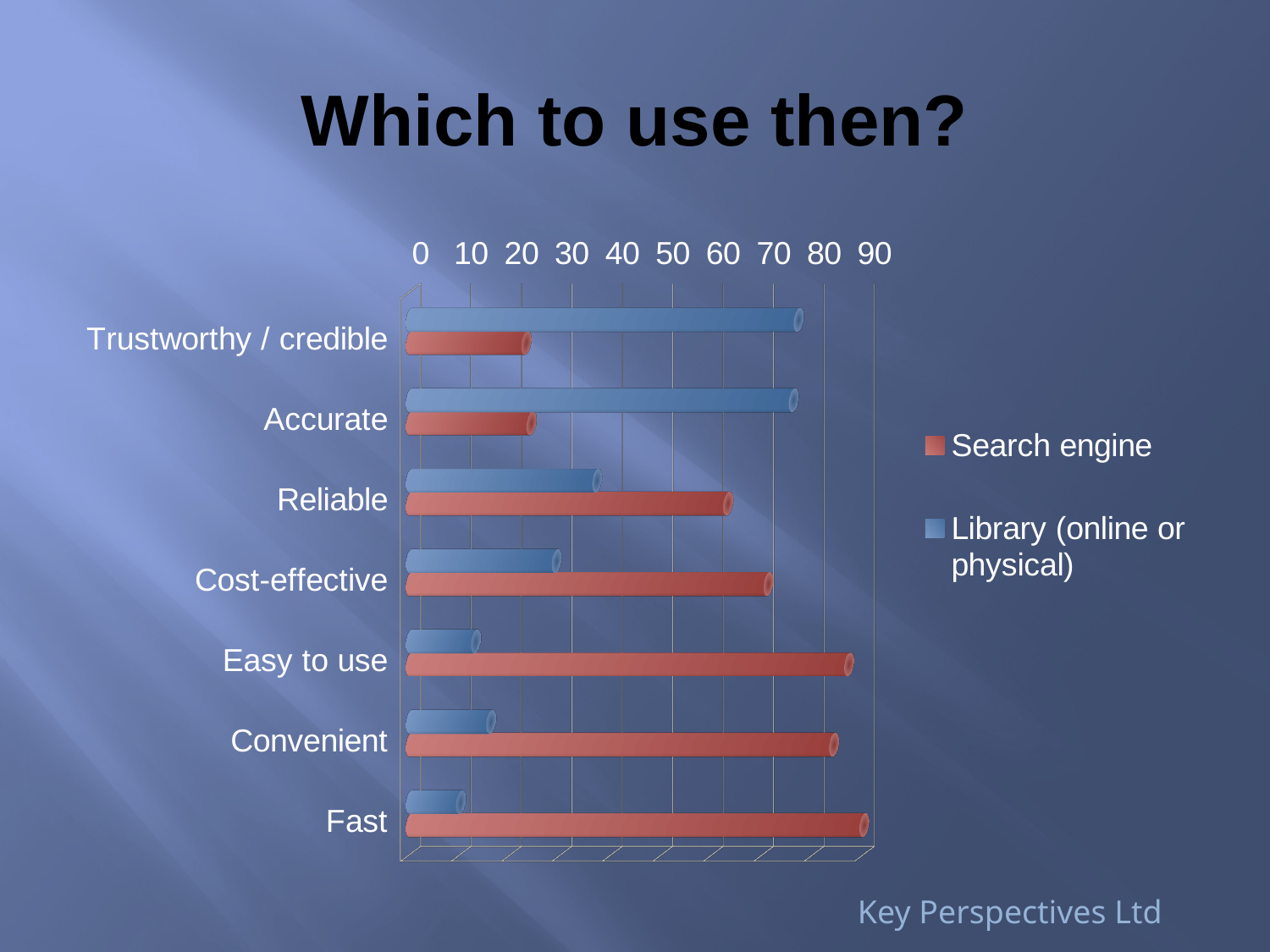
Is the Search engine value for Fast greater or less than 80? greater What kind of chart is shown on the slide? bar chart How many series does the legend list? 2 Is the Library (online or physical) value for Cost-effective greater or less than 40? less What is the title of the slide containing the chart? Which to use then? Is the Library (online or physical) value for Fast greater or less than 20? less For Easy to use, which series has the larger value, Search engine or Library (online or physical)? Search engine How many categories are plotted on the chart? 7 Which series is shown in blue in the legend? Library (online or physical) For Trustworthy / credible, which series has the larger value, Search engine or Library (online or physical)? Library (online or physical)